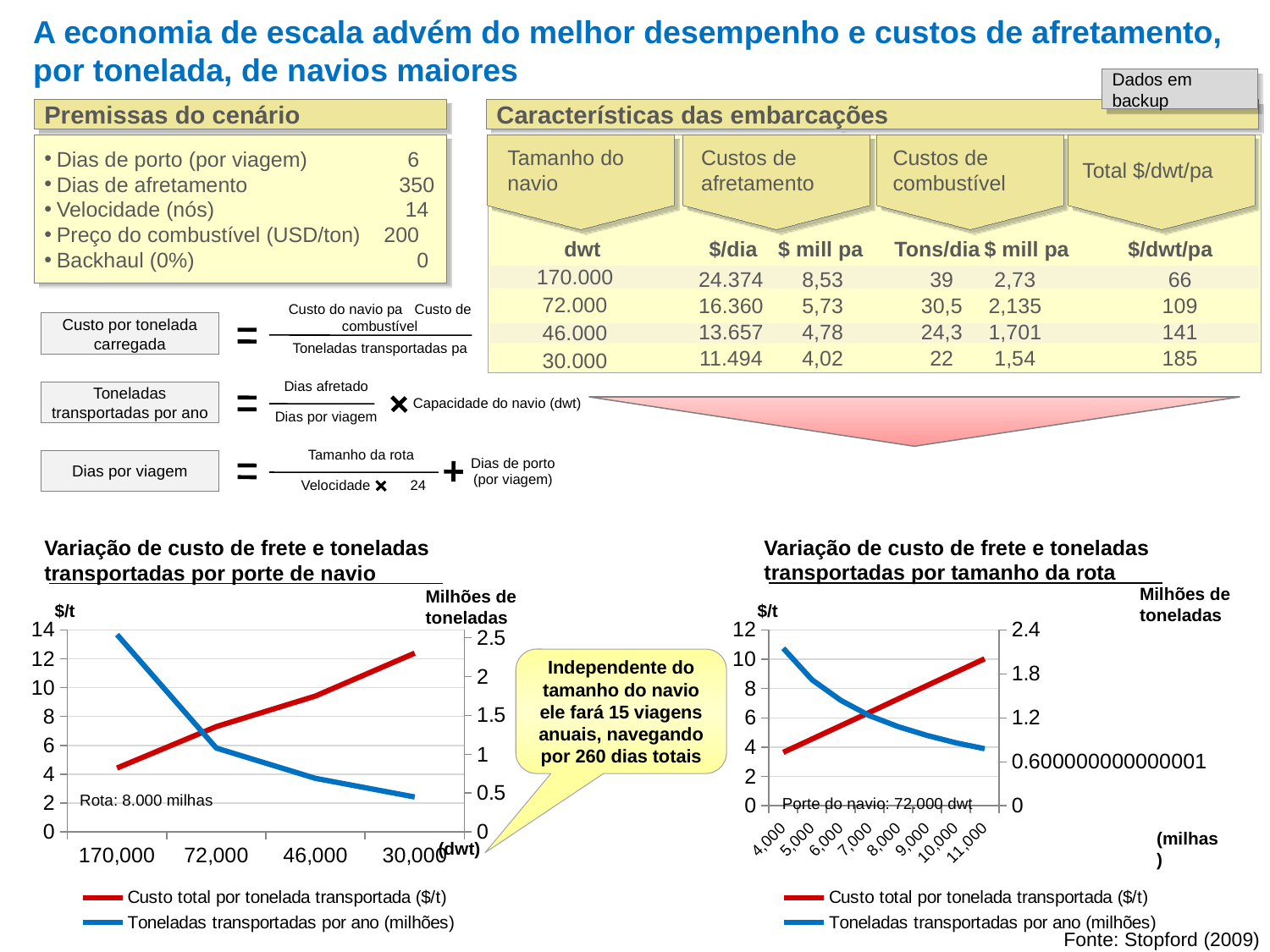
What colour is the 'Toneladas transportadas por ano (milhões)' line in the right chart, 'Variação de custo de frete e toneladas transportadas por tamanho da rota'? Blue How many ship-size categories are shown on the x axis of the left chart, 'Variação de custo de frete e toneladas transportadas por porte de navio'? 4 What kind of chart is the left chart, 'Variação de custo de frete e toneladas transportadas por porte de navio'? Line chart In the left chart, 'Variação de custo de frete e toneladas transportadas por porte de navio', does the 'Toneladas transportadas por ano (milhões)' line rise or fall from 170,000 dwt to 30,000 dwt? Fall In the left chart, 'Variação de custo de frete e toneladas transportadas por porte de navio', is the value of 'Custo total por tonelada transportada ($/t)' at 170,000 dwt greater or less than 6? less How many series does the legend of the left chart, 'Variação de custo de frete e toneladas transportadas por porte de navio', list? 2 In the left chart, 'Variação de custo de frete e toneladas transportadas por porte de navio', does the 'Custo total por tonelada transportada ($/t)' line rise or fall from 170,000 dwt to 30,000 dwt? Rise In the left chart, 'Variação de custo de frete e toneladas transportadas por porte de navio', is the value of 'Custo total por tonelada transportada ($/t)' at 30,000 dwt greater or less than 10? greater In the left chart, 'Variação de custo de frete e toneladas transportadas por porte de navio', is the value of 'Toneladas transportadas por ano (milhões)' at 30,000 dwt greater or less than 1? less In the right chart, 'Variação de custo de frete e toneladas transportadas por tamanho da rota', does the 'Custo total por tonelada transportada ($/t)' line rise or fall as the route length increases from 4,000 to 11,000 miles? Rise How many route-length points are shown on the x axis of the right chart, 'Variação de custo de frete e toneladas transportadas por tamanho da rota'? 8